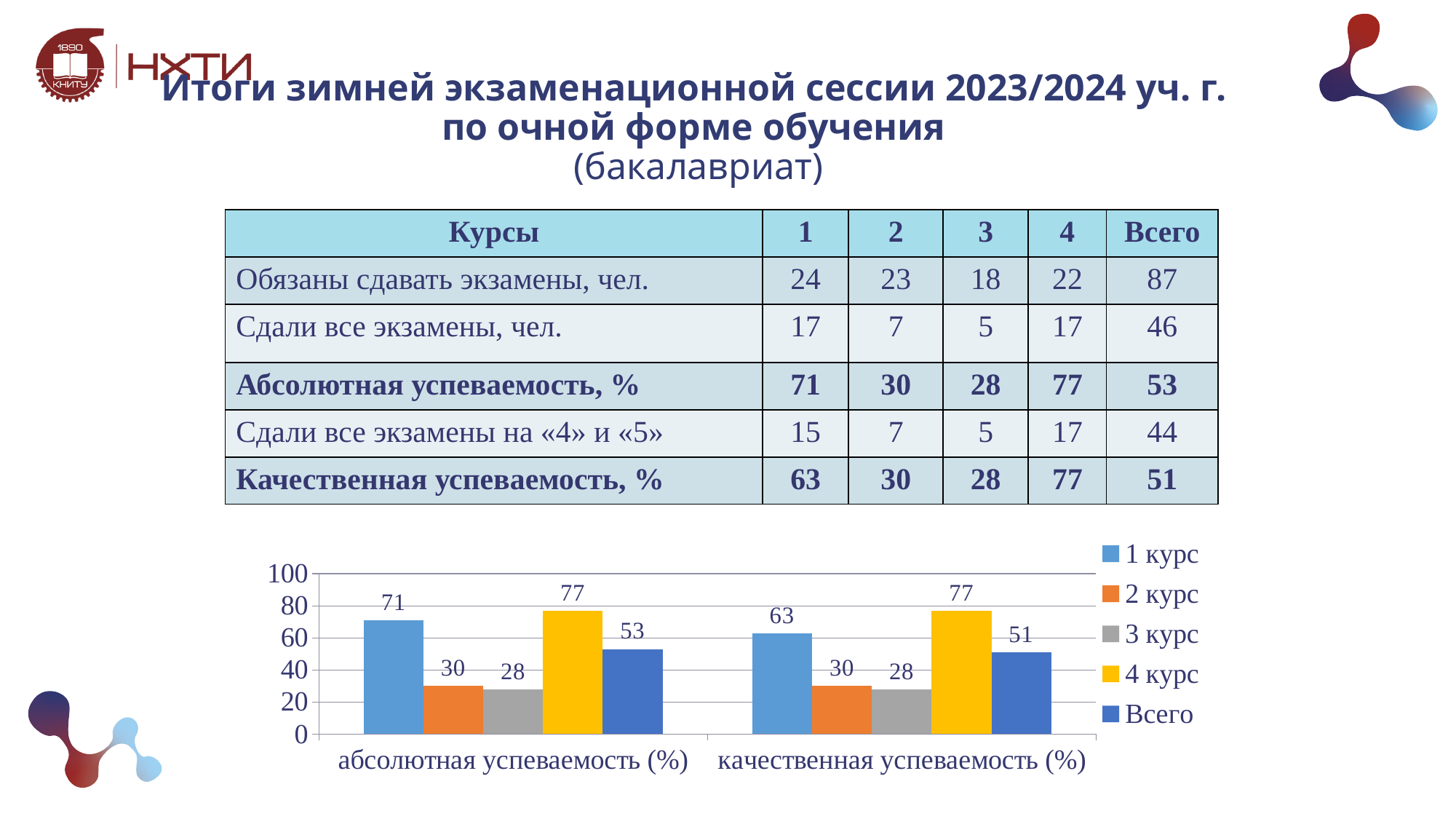
What is the difference between the 4 курс and 3 курс values in the абсолютная успеваемость (%) category? 49 Which series has the highest value in the абсолютная успеваемость (%) category? 4 курс What colour are the bars for 4 курс in the chart? yellow Which is larger: the 1 курс value for абсолютная успеваемость (%) or the 1 курс value for качественная успеваемость (%)? абсолютная успеваемость (%) What type of chart is shown on the slide? bar chart What is the value for Всего in the качественная успеваемость (%) category? 51 Is the value for 2 курс in the абсолютная успеваемость (%) category greater or less than 40? less Which series has the lowest value in the качественная успеваемость (%) category? 3 курс How many categories are shown on the x axis of the chart? 2 What is the value for 1 курс in the абсолютная успеваемость (%) category? 71 How many series does the chart legend list? 5 What is the value for 1 курс in the качественная успеваемость (%) category? 63